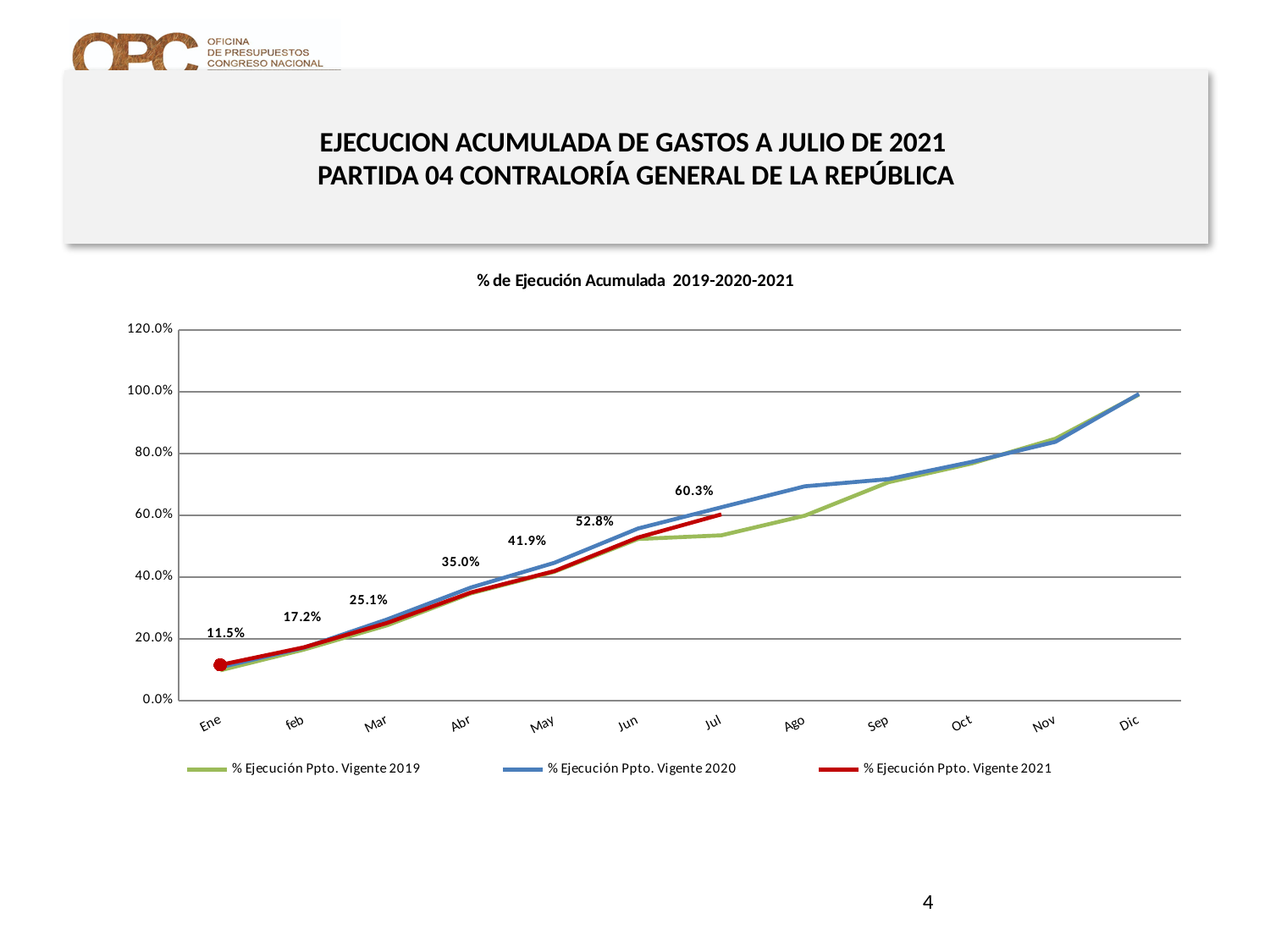
What is the value for % Ejecución Ppto. Vigente 2021 in Jul? 60.3% Does the % Ejecución Ppto. Vigente 2021 line rise or fall from Ene to Jul? rise How many series does the legend list? 3 Is the value for % Ejecución Ppto. Vigente 2019 in Dic greater or less than 80.0%? greater What is the difference between the % Ejecución Ppto. Vigente 2021 values for Jul and Jun? 7.5% What is the value for % Ejecución Ppto. Vigente 2021 in Abr? 35.0% How many months are shown on the x axis? 12 Which series is drawn in red? % Ejecución Ppto. Vigente 2021 What is the value for % Ejecución Ppto. Vigente 2021 in Ene? 11.5% What is the difference between the % Ejecución Ppto. Vigente 2021 values for Mar and Feb? 7.9% What is the title of the chart? % de Ejecución Acumulada 2019-2020-2021 What kind of chart is shown on the slide? line chart